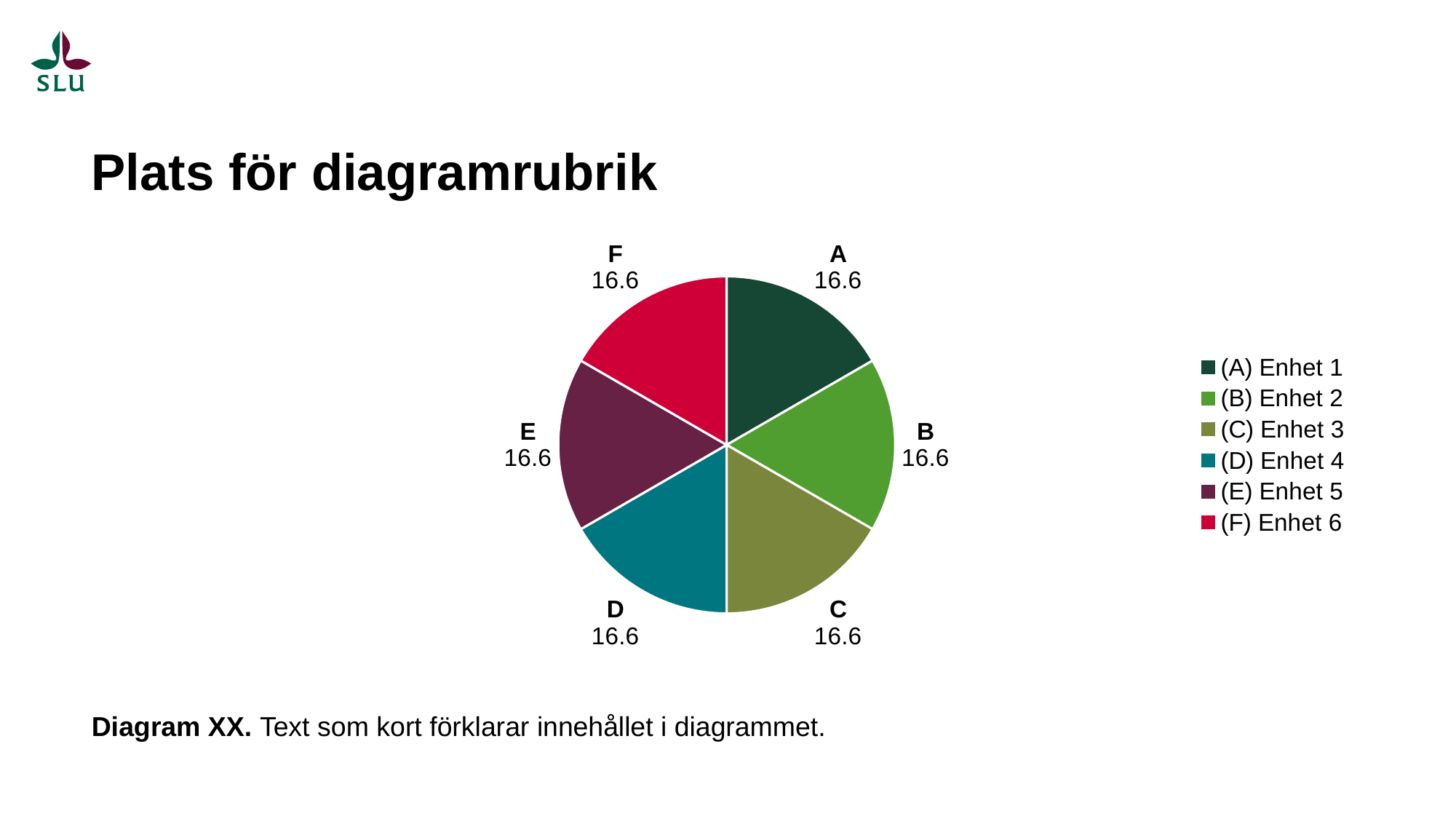
What is the difference between the values for slice B and slice E? 0 Which is larger, the value for slice A or the value for slice C? They are equal Is the value for slice B greater or less than 20? less What value is shown for slice A in the pie chart? 16.6 What is the title shown above the chart? Plats för diagramrubrik How many entries does the legend list? 6 What value is shown for slice D in the pie chart? 16.6 Which legend entry corresponds to slice D? (D) Enhet 4 What value is shown for slice F in the pie chart? 16.6 How many slices does the pie chart have? 6 What kind of chart is shown on the slide? Pie chart